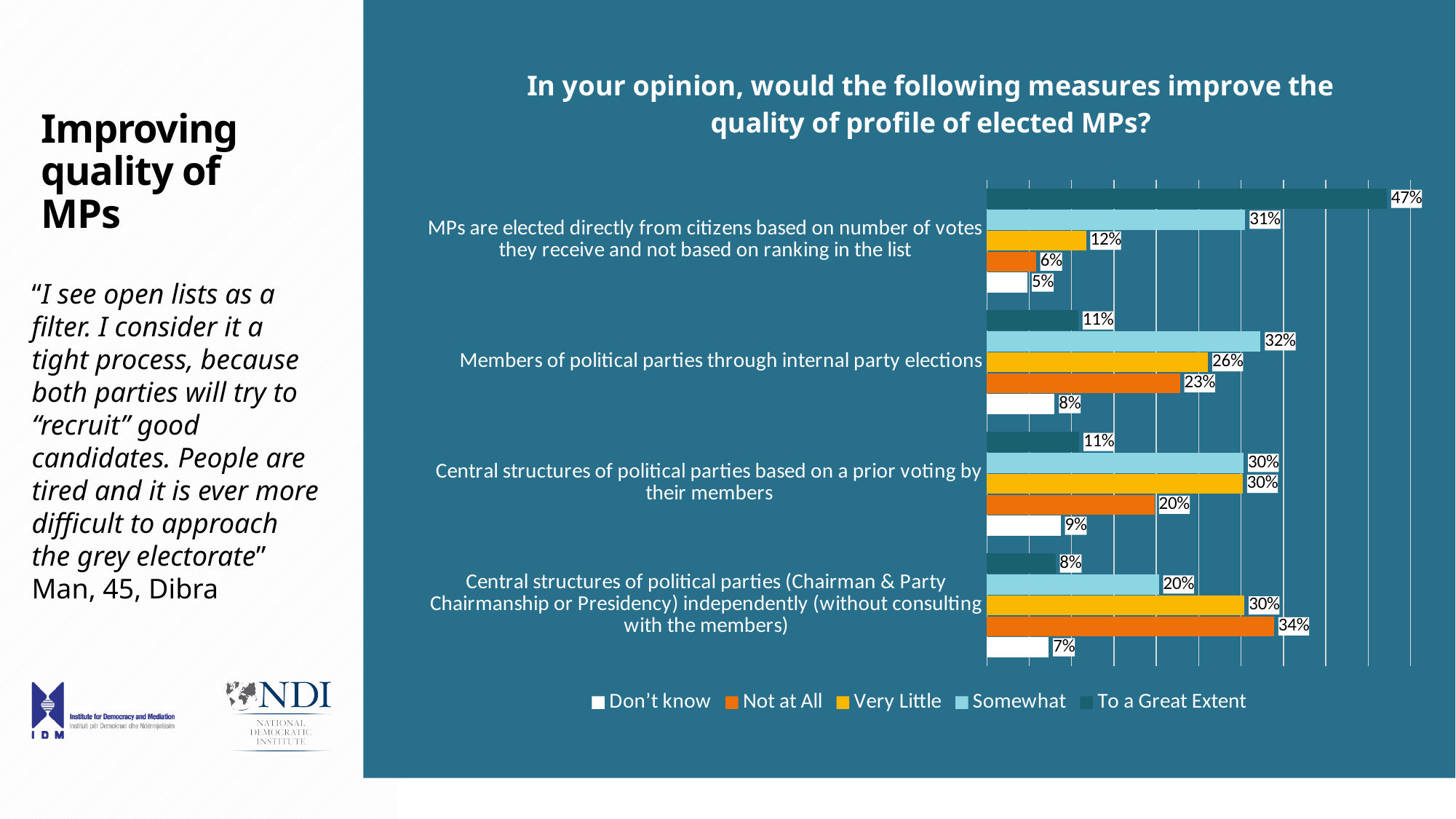
Which measure has the highest 'To a Great Extent' value? MPs are elected directly from citizens based on number of votes they receive and not based on ranking in the list What is the 'Not at All' value for 'Central structures of political parties (Chairman & Party Chairmanship or Presidency) independently (without consulting with the members)'? 34% What is the 'Somewhat' value for 'Members of political parties through internal party elections'? 32% What is the difference between the 'To a Great Extent' value for 'MPs are elected directly from citizens...' and the 'To a Great Extent' value for 'Members of political parties through internal party elections'? 36% What type of chart is shown on the slide? Bar chart What percentage of respondents said 'To a Great Extent' for the measure 'MPs are elected directly from citizens based on number of votes they receive and not based on ranking in the list'? 47% Which legend entry is shown in orange? Not at All How many series does the legend list? 5 Which is larger: the 'Not at All' value for 'Members of political parties through internal party elections' or the 'Not at All' value for 'Central structures of political parties based on a prior voting by their members'? Members of political parties through internal party elections How many measures (categories) are shown in the chart? 4 Which measure has the lowest 'Somewhat' value? Central structures of political parties (Chairman & Party Chairmanship or Presidency) independently (without consulting with the members) What is the 'Don't know' value for 'Central structures of political parties based on a prior voting by their members'? 9%